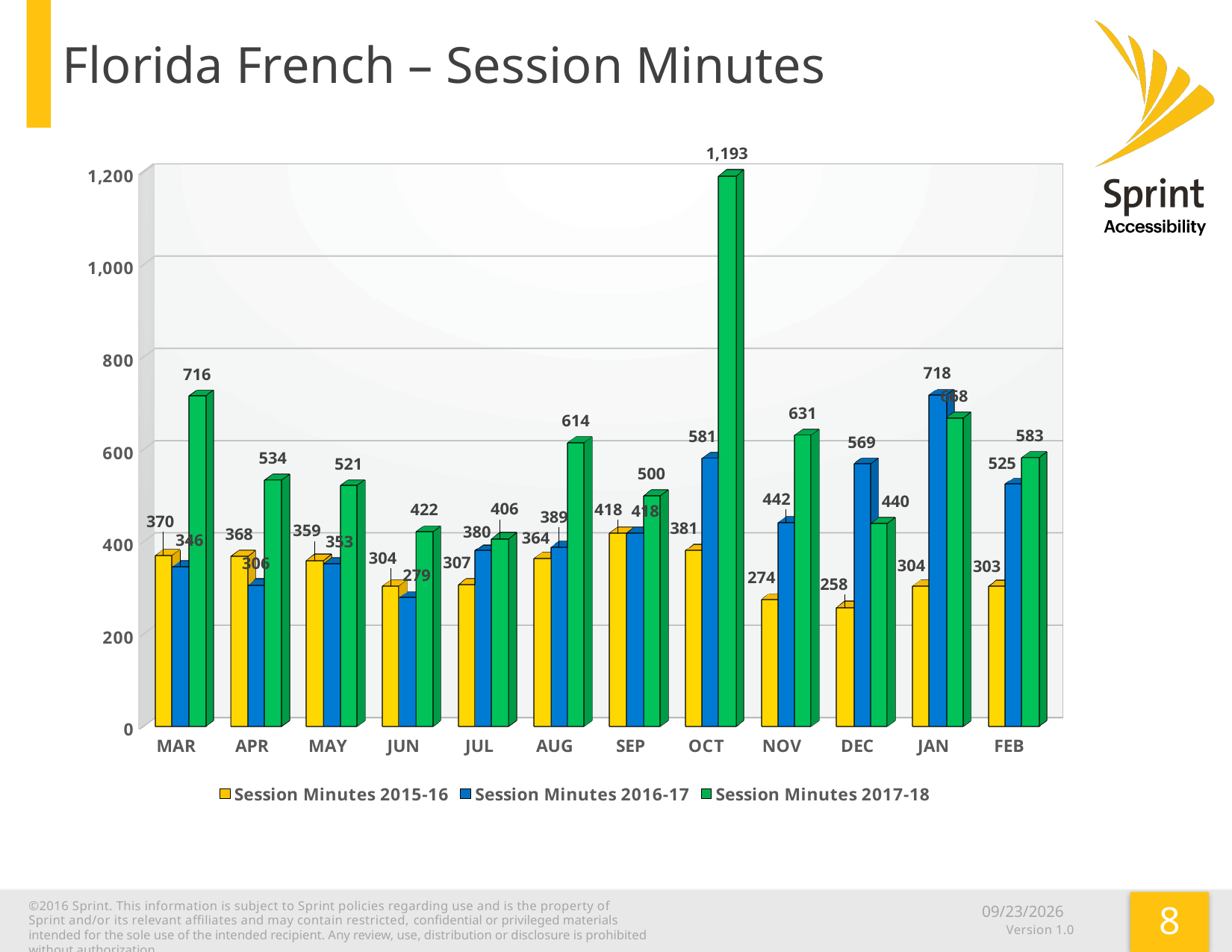
How many months are shown on the x axis? 12 Which month has the highest value for Session Minutes 2016-17? JAN What is the value for Session Minutes 2015-16 in SEP? 418 What is the difference between Session Minutes 2017-18 and Session Minutes 2016-17 in MAR? 370 What kind of chart is shown on the slide? Bar chart What is the value for Session Minutes 2016-17 in DEC? 569 Which month has the highest value for Session Minutes 2017-18? OCT Is the value for Session Minutes 2017-18 in NOV greater or less than 600? greater What is the value for Session Minutes 2017-18 in OCT? 1,193 How many series does the legend list? 3 Which is larger in DEC: Session Minutes 2016-17 or Session Minutes 2017-18? Session Minutes 2016-17 Which month has the lowest value for Session Minutes 2015-16? DEC